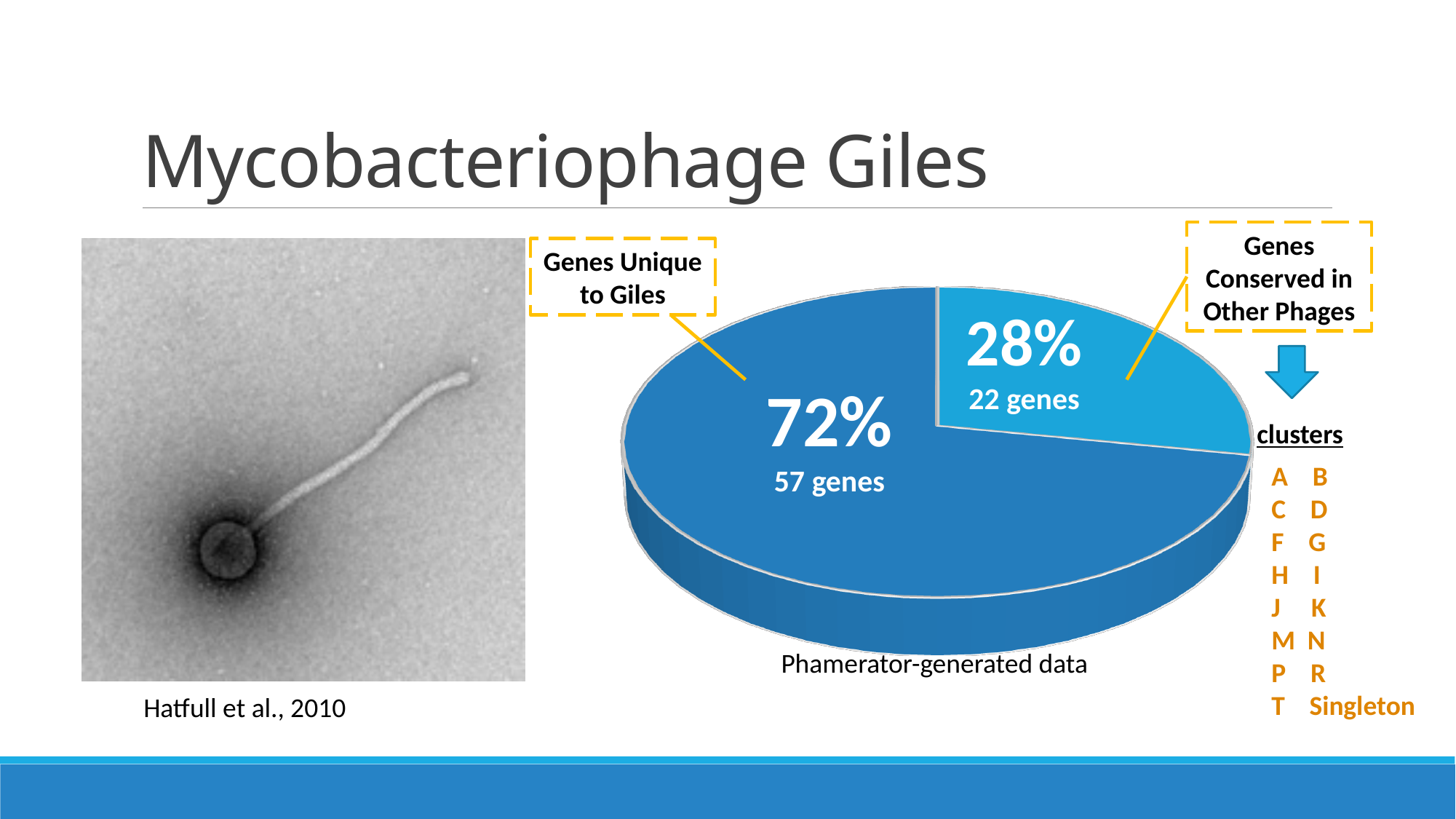
Which slice of the pie is larger: Genes Unique to Giles or Genes Conserved in Other Phages? Genes Unique to Giles What percentage of genes are unique to Giles? 72% Is the share of genes unique to Giles greater or less than 50%? greater What percentage of genes are conserved in other phages? 28% What is the source of the data noted below the pie chart? Phamerator-generated data How many slices does the pie chart have? 2 What kind of chart is shown on the slide? pie chart Which category has the smallest slice of the pie? Genes Conserved in Other Phages How many genes are unique to Giles? 57 genes What is the total number of genes represented in the pie chart? 79 How many genes are conserved in other phages? 22 genes How many more genes are unique to Giles than are conserved in other phages? 35